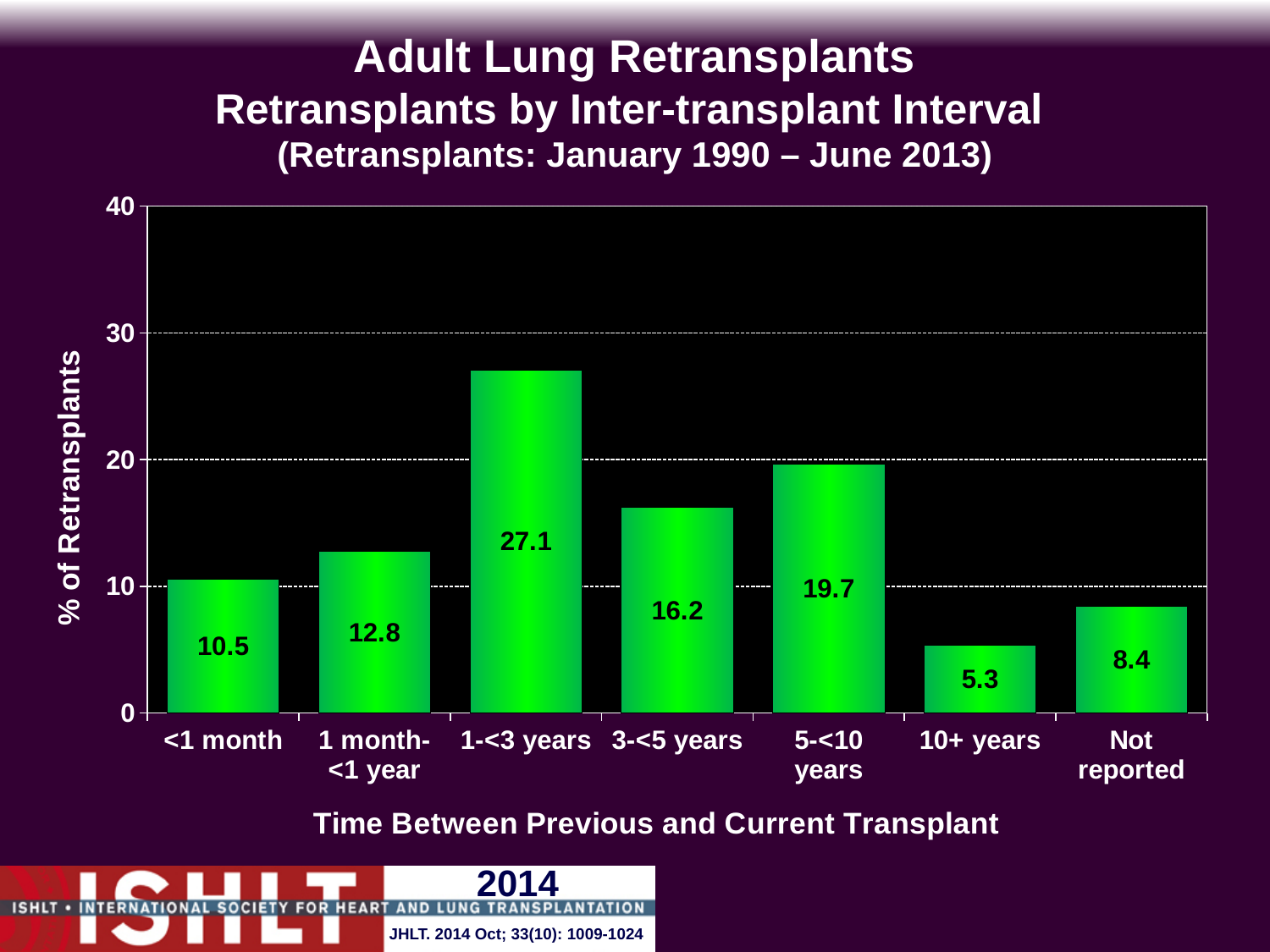
Is the value for 5-<10 years greater or less than 20? less Which inter-transplant interval category has the lowest percentage of retransplants? 10+ years What is the label of the x axis? Time Between Previous and Current Transplant What is the label of the y axis? % of Retransplants Which inter-transplant interval category has the highest percentage of retransplants? 1-<3 years What is the difference between the values for 1-<3 years and 3-<5 years? 10.9 What percentage of retransplants had an inter-transplant interval of 1-<3 years? 27.1 What percentage of retransplants occurred 5-<10 years after the previous transplant? 19.7 Which is larger, the value for <1 month or the value for 1 month-<1 year? 1 month-<1 year What kind of chart is shown on the slide? bar chart What is the value for the 'Not reported' category? 8.4 How many inter-transplant interval categories are shown on the x axis? 7